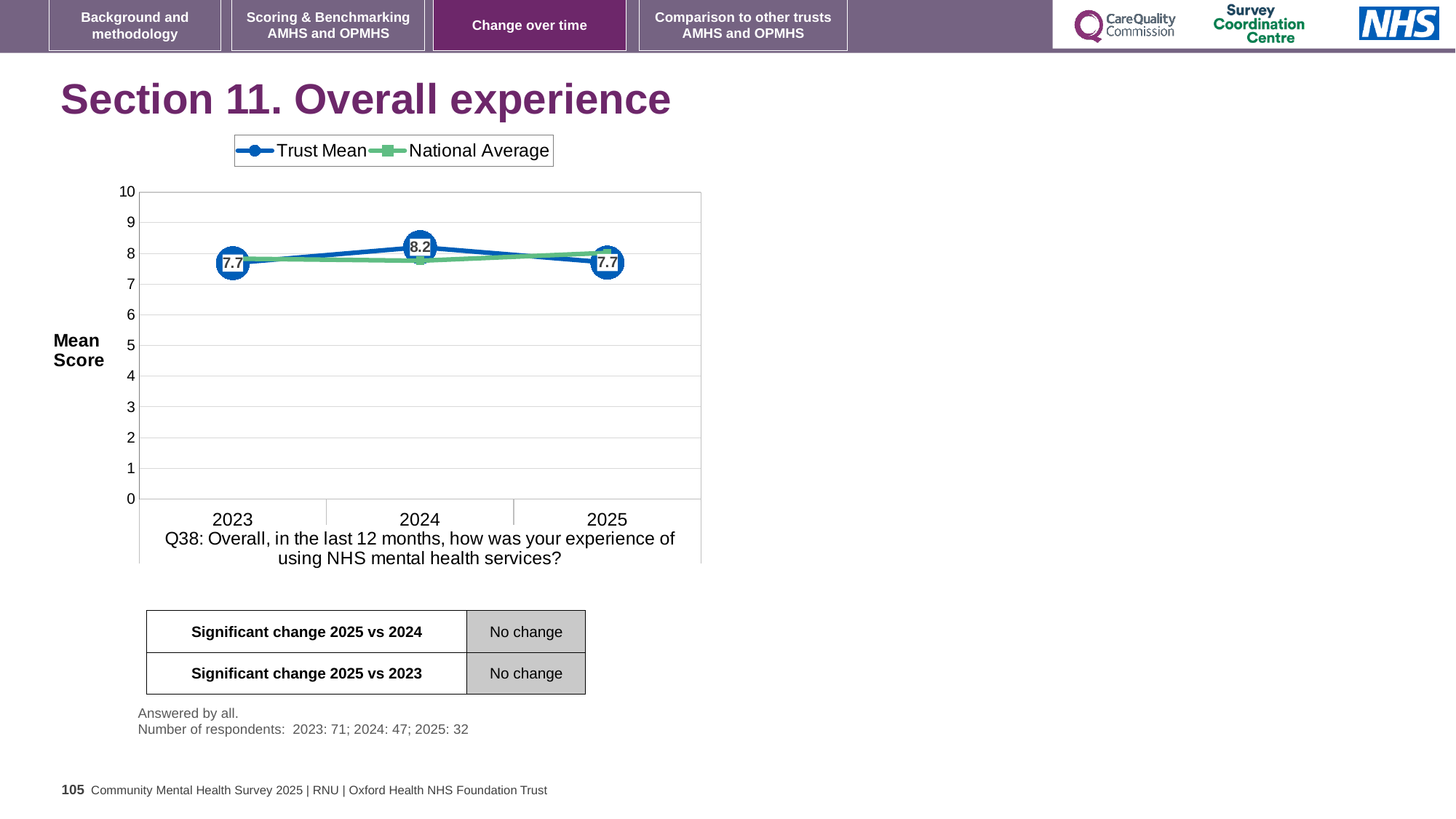
How many series does the chart legend list? 2 In which year is the Trust Mean highest? 2024 What kind of chart is shown on the slide? line chart How many years are shown on the x axis of the chart? 3 What is the Trust Mean score for 2025? 7.7 Is the National Average value for 2023 greater or less than 7? greater What is the difference between the Trust Mean in 2024 and the Trust Mean in 2025? 0.5 What is the label on the y axis of the chart? Mean Score In 2024, which is higher: the Trust Mean or the National Average? Trust Mean Is the National Average value for 2025 greater or less than 9? less What is the Trust Mean score for 2023? 7.7 What is the Trust Mean score for 2024? 8.2